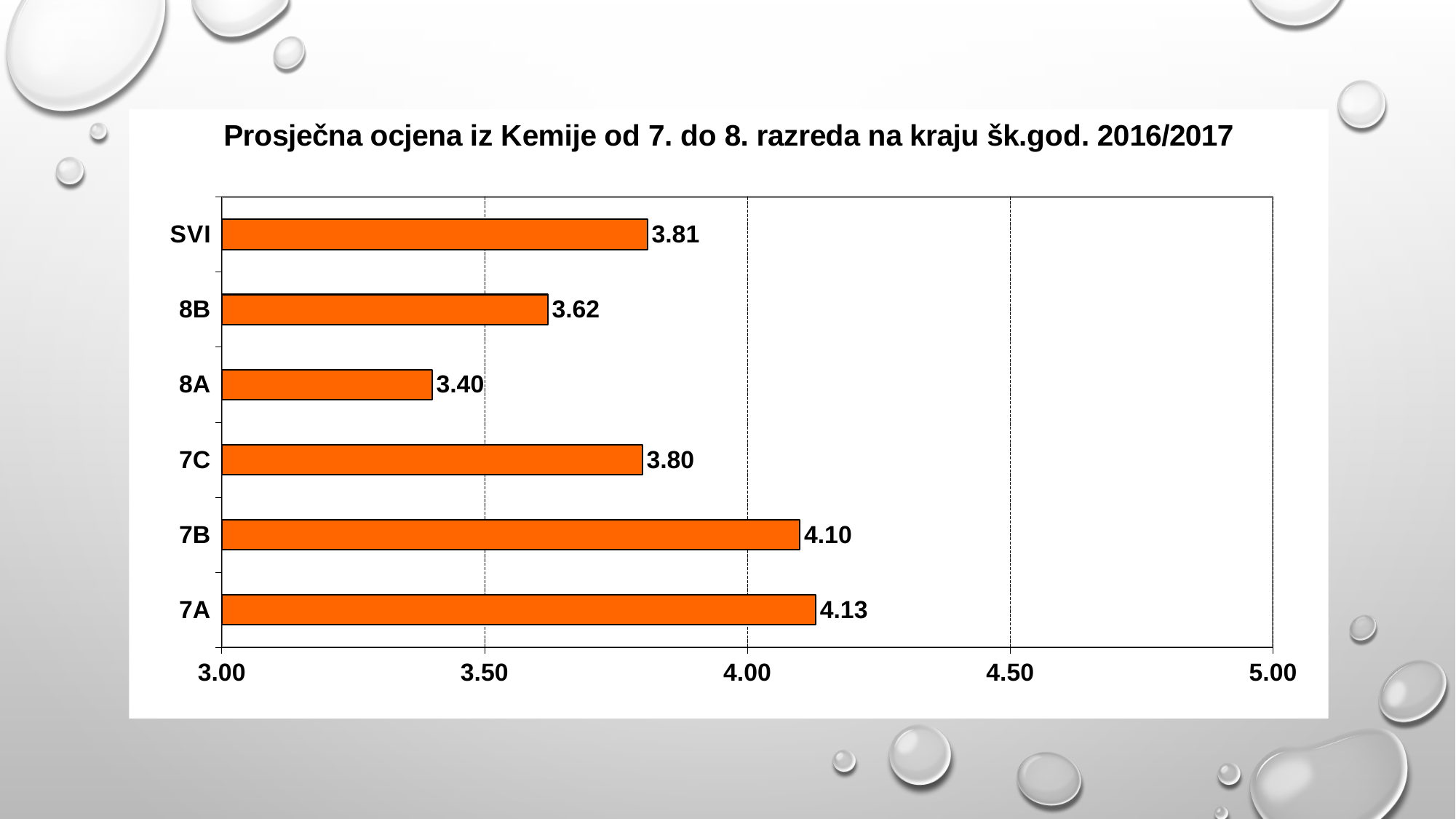
What is the value shown for 8B? 3.62 How many categories are shown on the chart? 6 What is the average chemistry grade for class 7A? 4.13 What is the value shown for SVI? 3.81 Which class has the lowest average grade? 8A Which is larger, the value for 7C or the value for 8B? 7C What kind of chart is shown on the slide? Bar chart What is the difference between the values for 8B and 8A? 0.22 Is the value for 7B greater or less than 4.00? greater Which class has the highest average grade? 7A What is the title of the chart? Prosječna ocjena iz Kemije od 7. do 8. razreda na kraju šk.god. 2016/2017 What is the difference between the values for 7B and 8A? 0.70